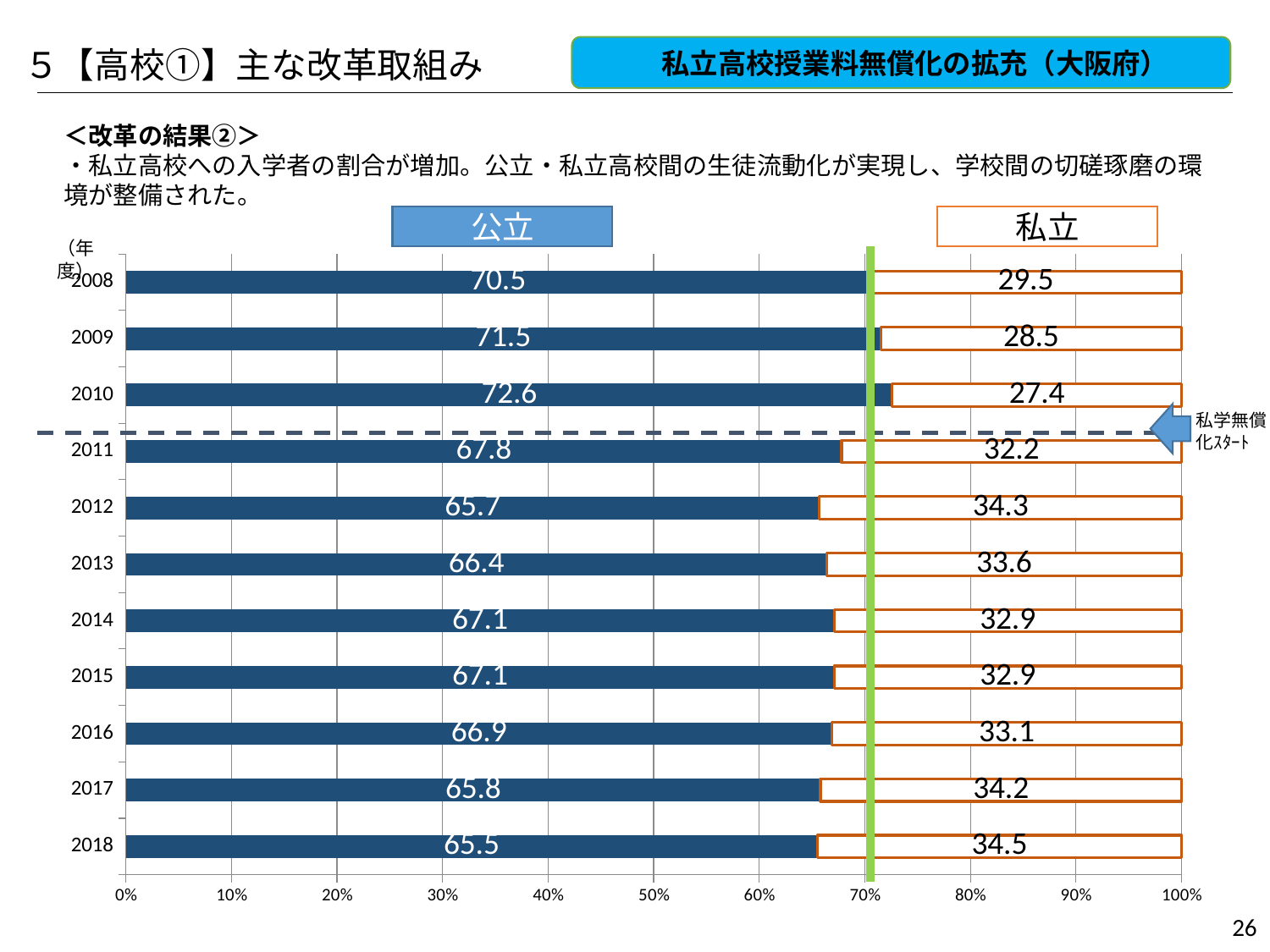
What kind of chart is shown on the slide? Stacked bar chart How many years are shown on the chart? 11 What is the value for 私立 in 2018? 34.5 What is the total of the stacked bar for 2014? 100 How many series does the chart show? 2 What is the difference between the 私立 values for 2018 and 2008? 5.0 What is the value for 公立 in 2008? 70.5 What is the value for 私立 in 2011? 32.2 Is the 公立 value for 2018 greater or less than 70%? less In which year is the 私立 value lowest? 2010 Which is larger, the 公立 value for 2009 or the 公立 value for 2012? 2009 In which year is the 公立 value highest? 2010